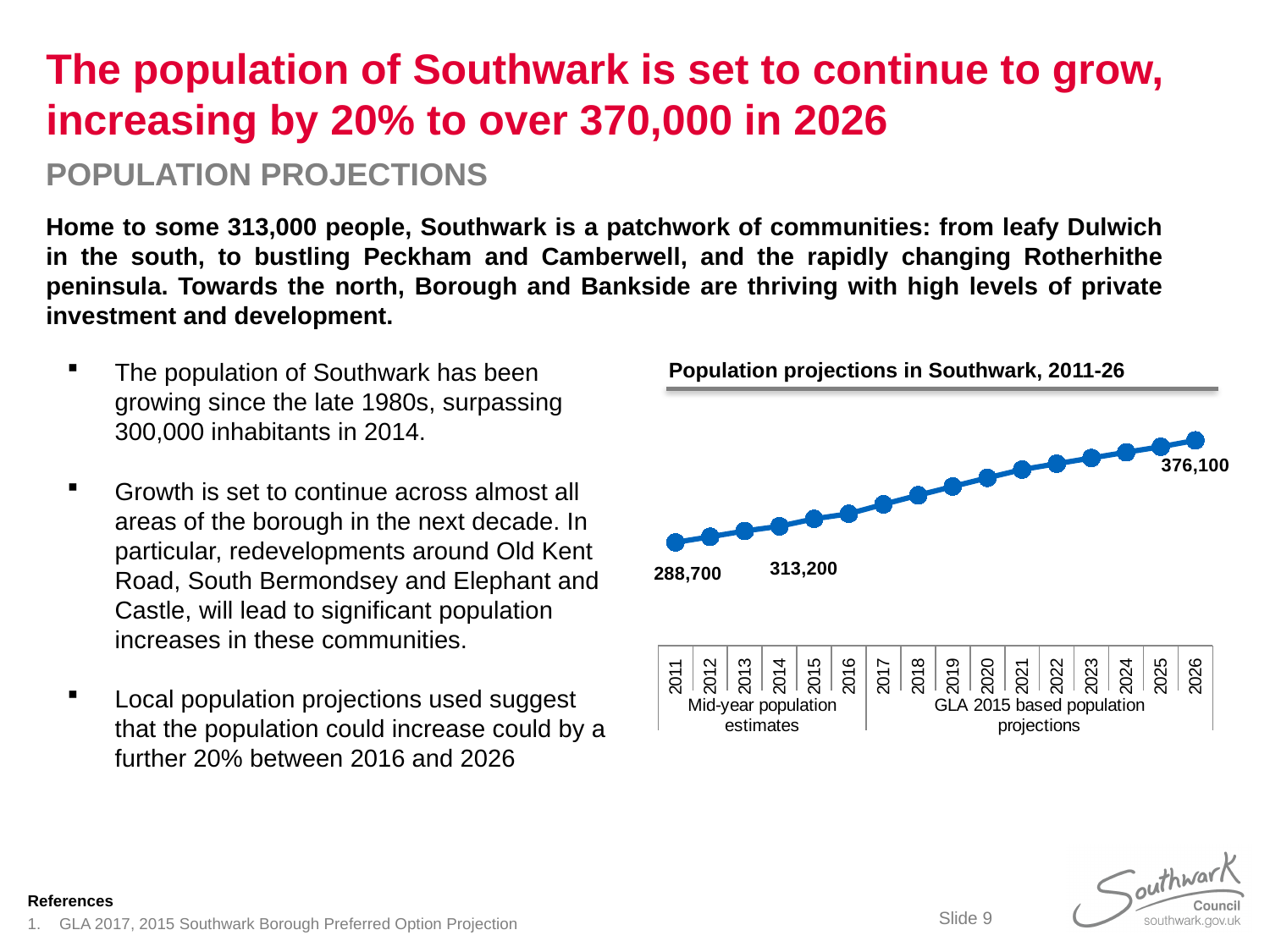
What is the title of the chart? Population projections in Southwark, 2011-26 Which year has the lowest population value in the chart? 2011 Do the population values rise or fall from 2011 to 2026? Rise What is the population value labelled for 2011 in the chart? 288,700 Is the population value for 2020 larger or smaller than the value for 2013? Larger What is the population value labelled for 2026 in the chart? 376,100 Which year has the highest population value in the chart? 2026 Which years on the x axis are grouped under 'Mid-year population estimates'? 2011 to 2016 What is the difference between the labelled values for 2026 and 2011? 87,400 How many years (data points) are plotted on the x axis? 16 What type of chart is shown on the slide? Line chart What is the middle data label shown on the line between 288,700 and 376,100? 313,200